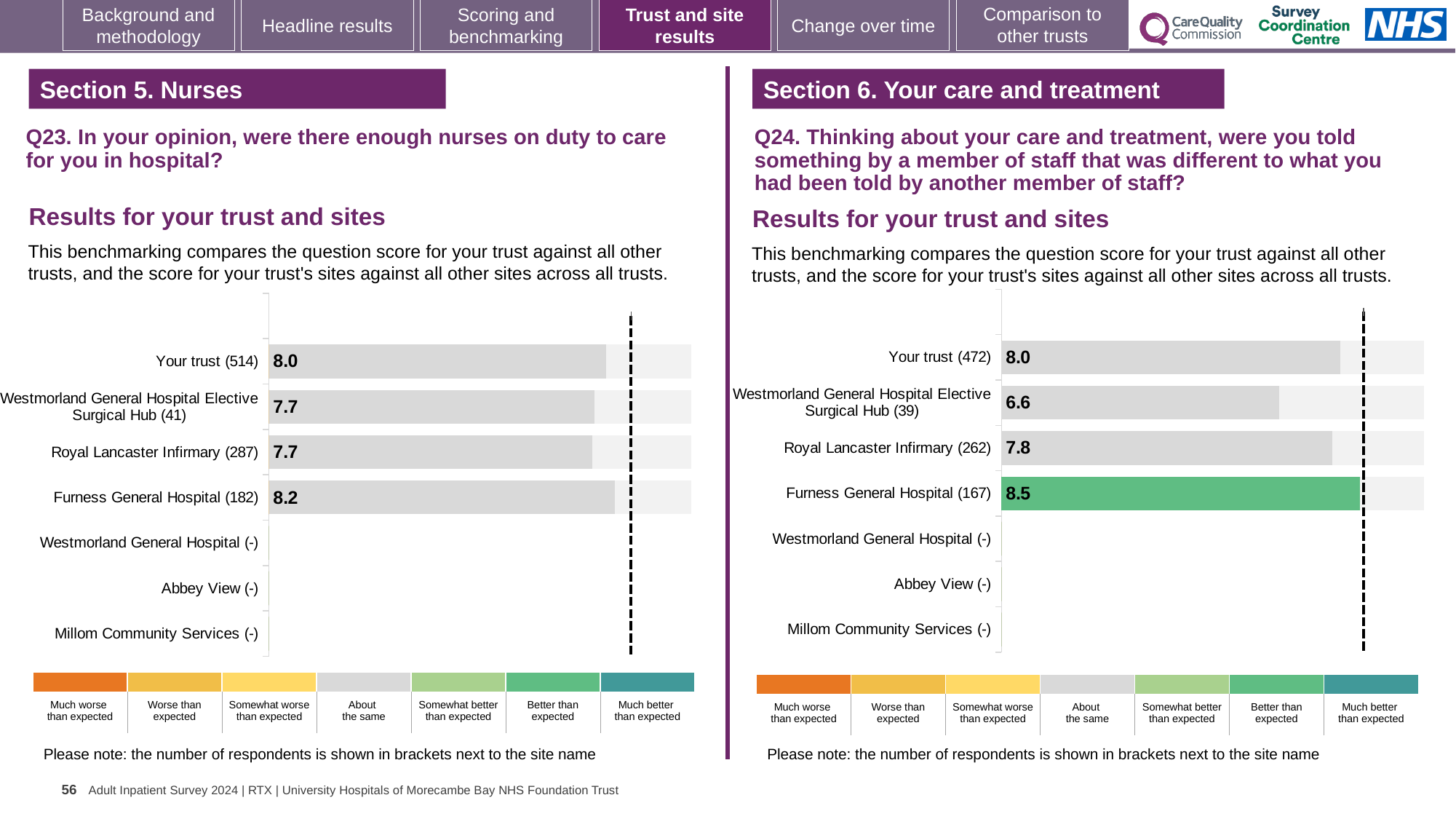
How many site rows are listed on the Q23 chart (left), including Your trust? 7 On the Q24 chart (right), what is the difference between the scores for Furness General Hospital and Westmorland General Hospital Elective Surgical Hub? 1.9 On the Q24 chart (right), which site's bar is coloured green, indicating 'Better than expected'? Furness General Hospital On the Q23 chart (left), what is the score for Furness General Hospital? 8.2 On the Q23 chart (left), what is the difference between the scores for Furness General Hospital and Royal Lancaster Infirmary? 0.5 On the Q24 chart (right), which site has the lowest score among those with a score shown? Westmorland General Hospital Elective Surgical Hub On the Q24 chart (right), what is the score for Royal Lancaster Infirmary? 7.8 On the Q23 chart (left), which site has the highest score? Furness General Hospital On the Q23 chart (left), what is the score for Your trust? 8.0 What kind of chart is used for the Q24 results (right)? Bar chart On the Q24 chart (right), which is larger: the score for Furness General Hospital or Your trust? Furness General Hospital On the Q24 chart (right), what is the score for Westmorland General Hospital Elective Surgical Hub? 6.6